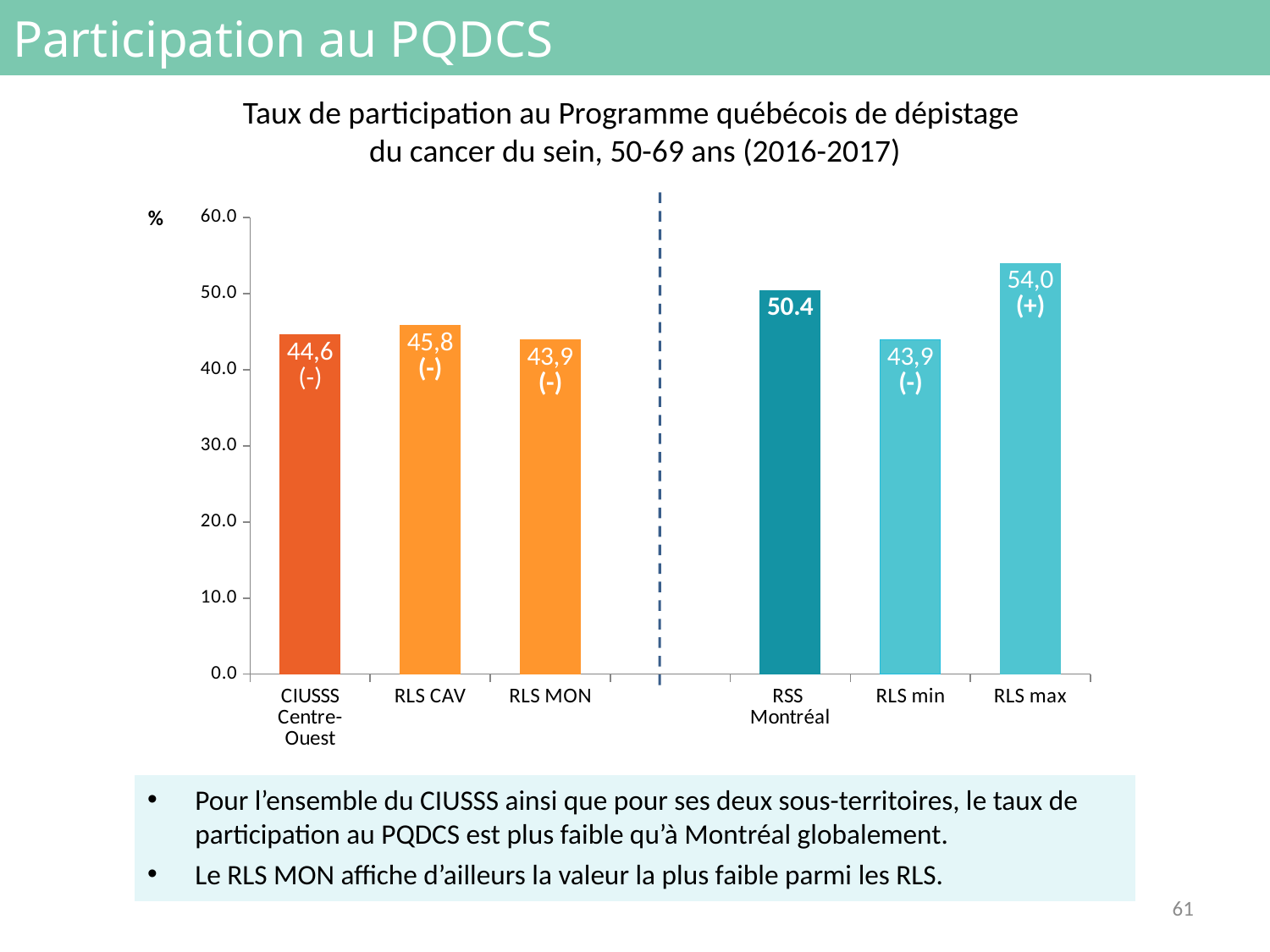
What is the difference between the values for RLS CAV and RLS MON? 1,9 What is the difference between the values for RLS CAV and CIUSSS Centre-Ouest? 1,2 Which is larger, the value for RLS CAV or the value for RLS MON? RLS CAV Is the value for RLS max greater or less than 50.0? greater What value is shown for RLS max? 54,0 What is the value shown for CIUSSS Centre-Ouest? 44,6 Among CIUSSS Centre-Ouest, RLS CAV and RLS MON, which has the lowest value? RLS MON What kind of chart is shown on the slide? Bar chart What value is shown for RSS Montréal? 50.4 What is the participation rate shown for RLS CAV? 45,8 How many bars are plotted in the chart? 6 Which category has the highest bar in the chart? RLS max